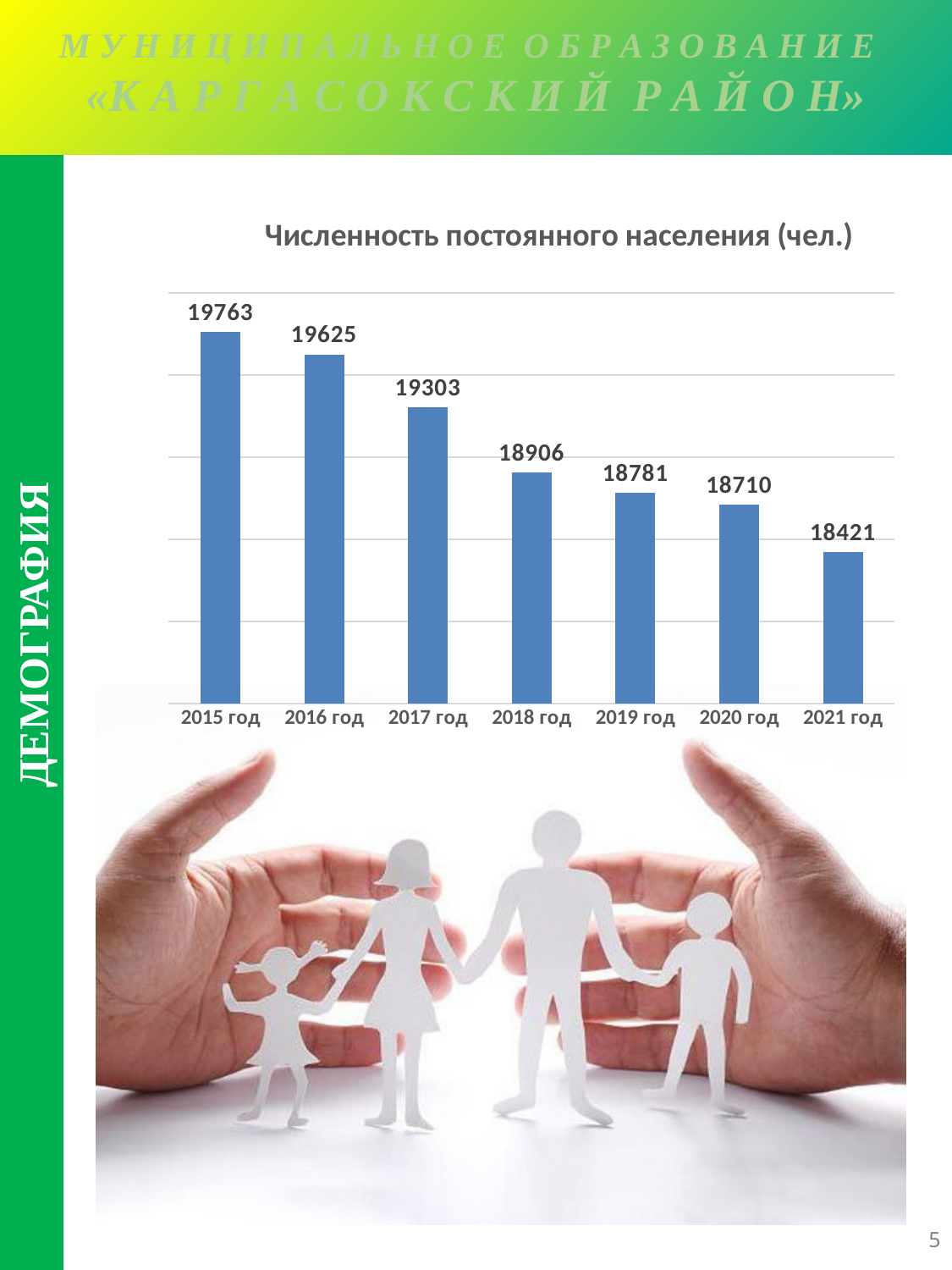
What is the value for 2018 год? 18906 Which year has the highest value? 2015 год What kind of chart is this? bar chart What is the value for 2021 год? 18421 Which is larger, the value for 2016 год or the value for 2019 год? 2016 год Do the values rise or fall from 2015 год to 2021 год? fall What is the difference between the values for 2015 год and 2021 год? 1342 What is the value for 2015 год? 19763 How many years are shown on the chart? 7 Which year has the lowest value? 2021 год What is the difference between the values for 2017 год and 2018 год? 397 What is the title of the chart? Численность постоянного населения (чел.)